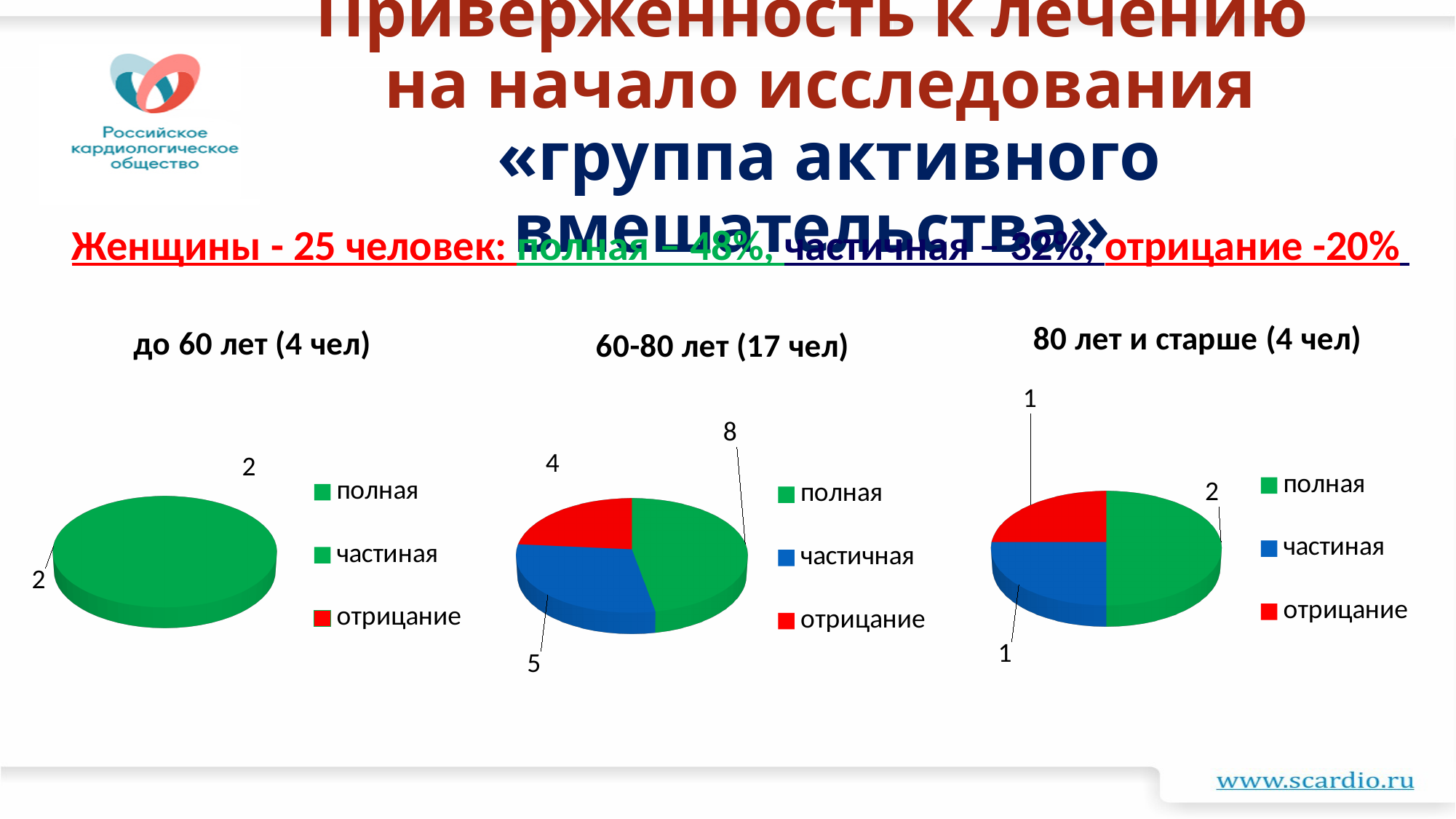
In the chart titled "60-80 лет (17 чел)", what is the value for частичная? 5 In the chart titled "60-80 лет (17 чел)", what is the value for полная? 8 In the chart titled "80 лет и старше (4 чел)", what is the value for отрицание? 1 In the chart titled "60-80 лет (17 чел)", what is the value for отрицание? 4 What type of chart is the chart titled "до 60 лет (4 чел)"? pie chart In the chart titled "60-80 лет (17 чел)", what is the difference between the values for полная and частичная? 3 In the chart titled "80 лет и старше (4 чел)", what is the value for полная? 2 In the chart titled "60-80 лет (17 чел)", which category has the largest slice? полная In the chart titled "80 лет и старше (4 чел)", what share of the pie does полная represent? 50% In the chart titled "80 лет и старше (4 чел)", which is larger, полная or частиная? полная How many entries does the legend of the chart titled "60-80 лет (17 чел)" list? 3 In the chart titled "60-80 лет (17 чел)", which category has the smallest slice? отрицание